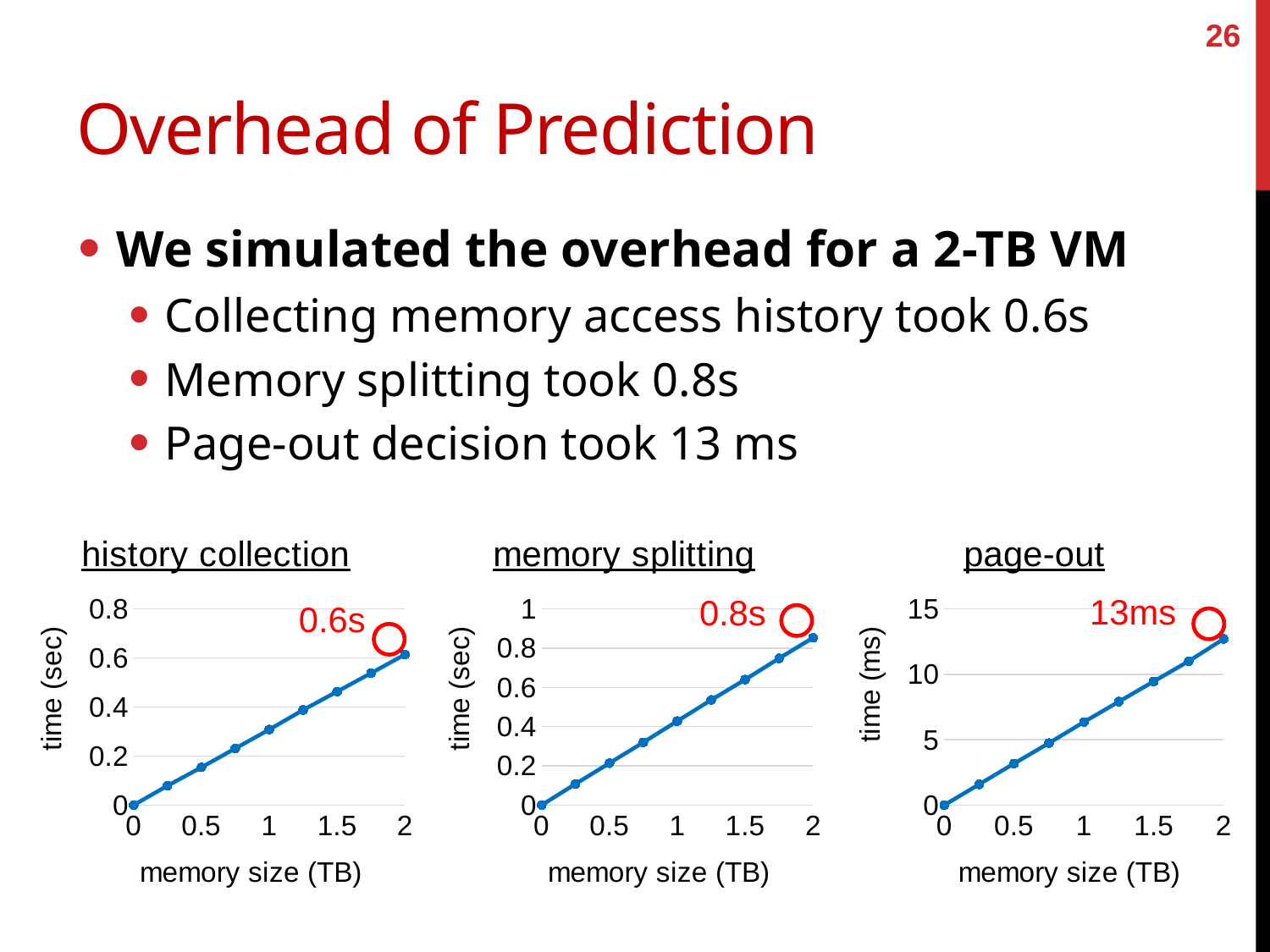
In the 'page-out' chart, is the time at a memory size of 1.5 TB greater or less than 5? greater In the 'memory splitting' chart, what is the annotated time at a memory size of 2 TB? 0.8s What kind of chart is the 'history collection' chart? line chart In the 'history collection' chart, is the time at a memory size of 0.5 TB greater or less than 0.2? less In the 'memory splitting' chart, is the time at a memory size of 1 TB greater or less than 0.6? less In the 'history collection' chart, what is the annotated time at a memory size of 2 TB? 0.6s In the 'page-out' chart, does the time rise or fall as memory size increases? rise How many data points are plotted in the 'memory splitting' chart? 9 In the 'history collection' chart, does the time rise or fall as memory size increases? rise What is the x-axis label shared by the three charts? memory size (TB) What is the y-axis label of the 'page-out' chart? time (ms) In the 'page-out' chart, what is the annotated time at a memory size of 2 TB? 13ms